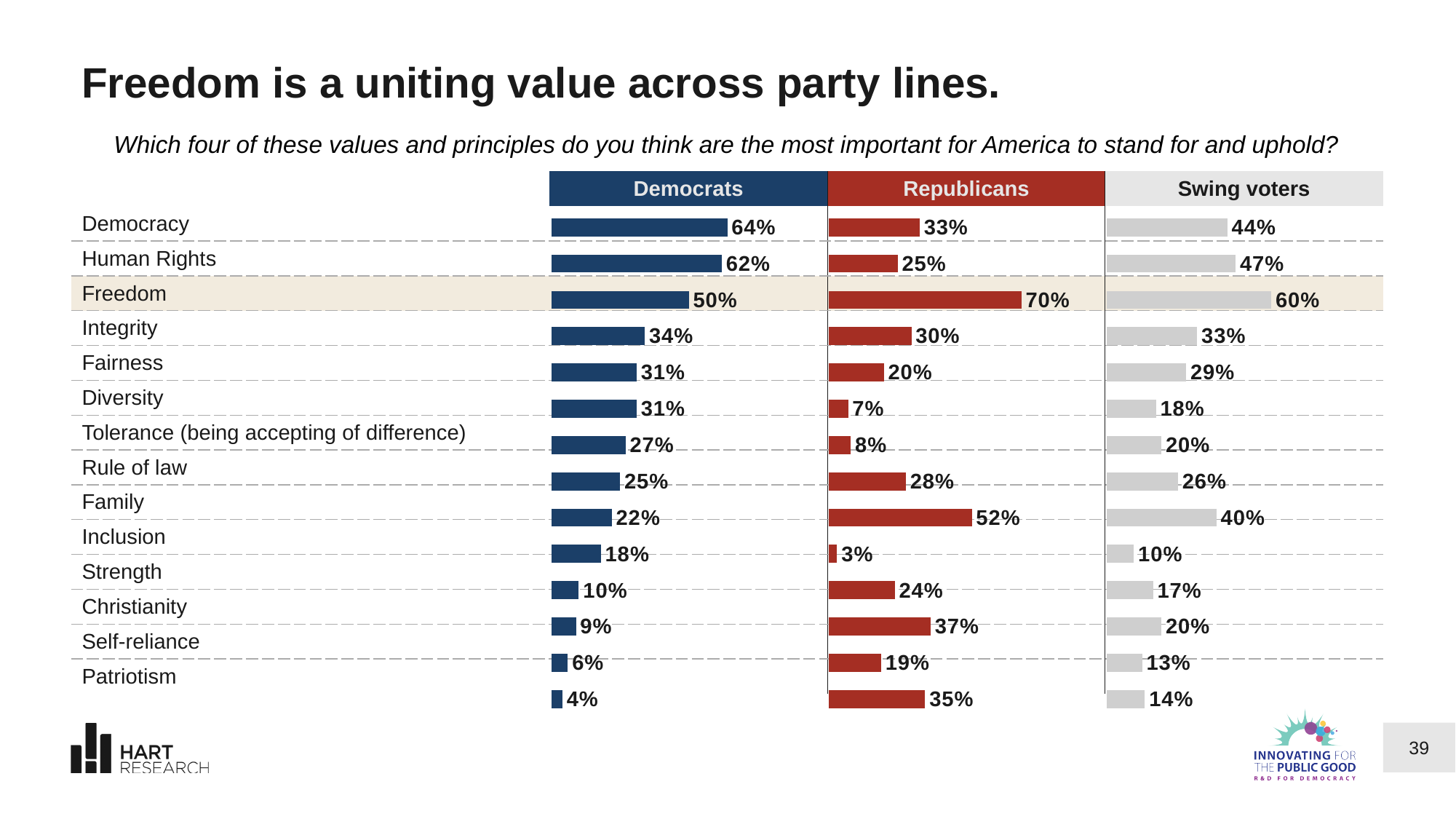
Which value has the lowest percentage among Democrats? Patriotism What is the difference between the Republican and Democrat percentages for Freedom? 20 percentage points How many values and principles are listed in the chart? 14 Which value has the highest percentage among Democrats? Democracy What percentage of Swing voters chose Human Rights? 47% How many groups (series) does the chart compare? 3 Which value has the highest percentage among Republicans? Freedom Which group has a higher percentage for Christianity, Democrats or Republicans? Republicans What percentage of Republicans chose Family? 52% Which row is highlighted with a shaded background in the chart? Freedom What percentage of Democrats chose Freedom as one of the most important values? 50% What type of chart is shown on the slide? Bar chart